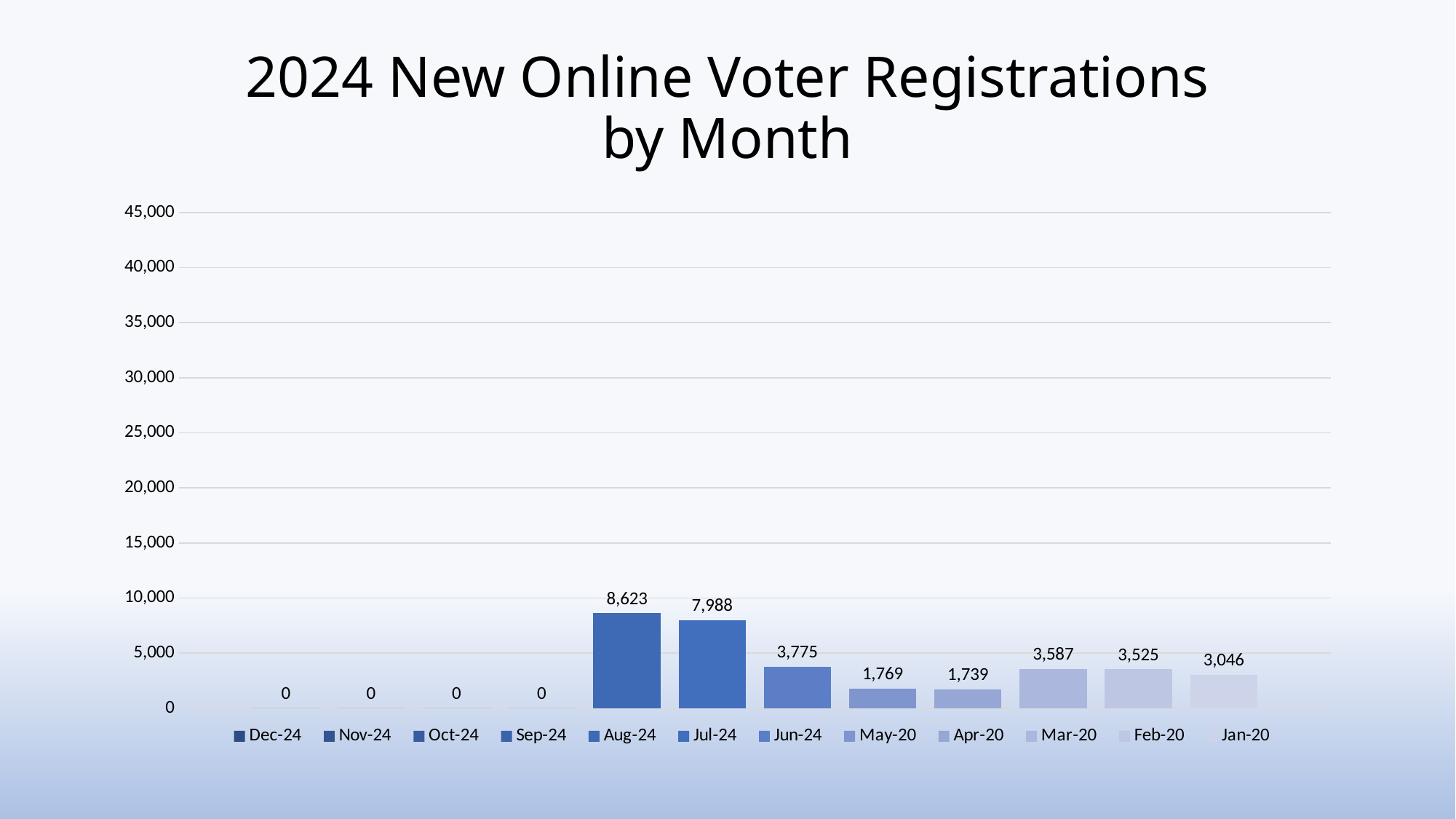
How many entries does the legend list? 12 How many bars show a value of 0? 4 Which month has the highest value? Aug-24 What kind of chart is shown on the slide? Bar chart What is the value for Aug-24? 8,623 What is the difference between the values for Aug-24 and Jul-24? 635 Which is larger, the value for Jun-24 or the value for Mar-20? Jun-24 What is the difference between the values for Mar-20 and Feb-20? 62 What is the value for Jan-20? 3,046 What is the value for Mar-20? 3,587 What is the value for Jun-24? 3,775 What is the value for Jul-24? 7,988